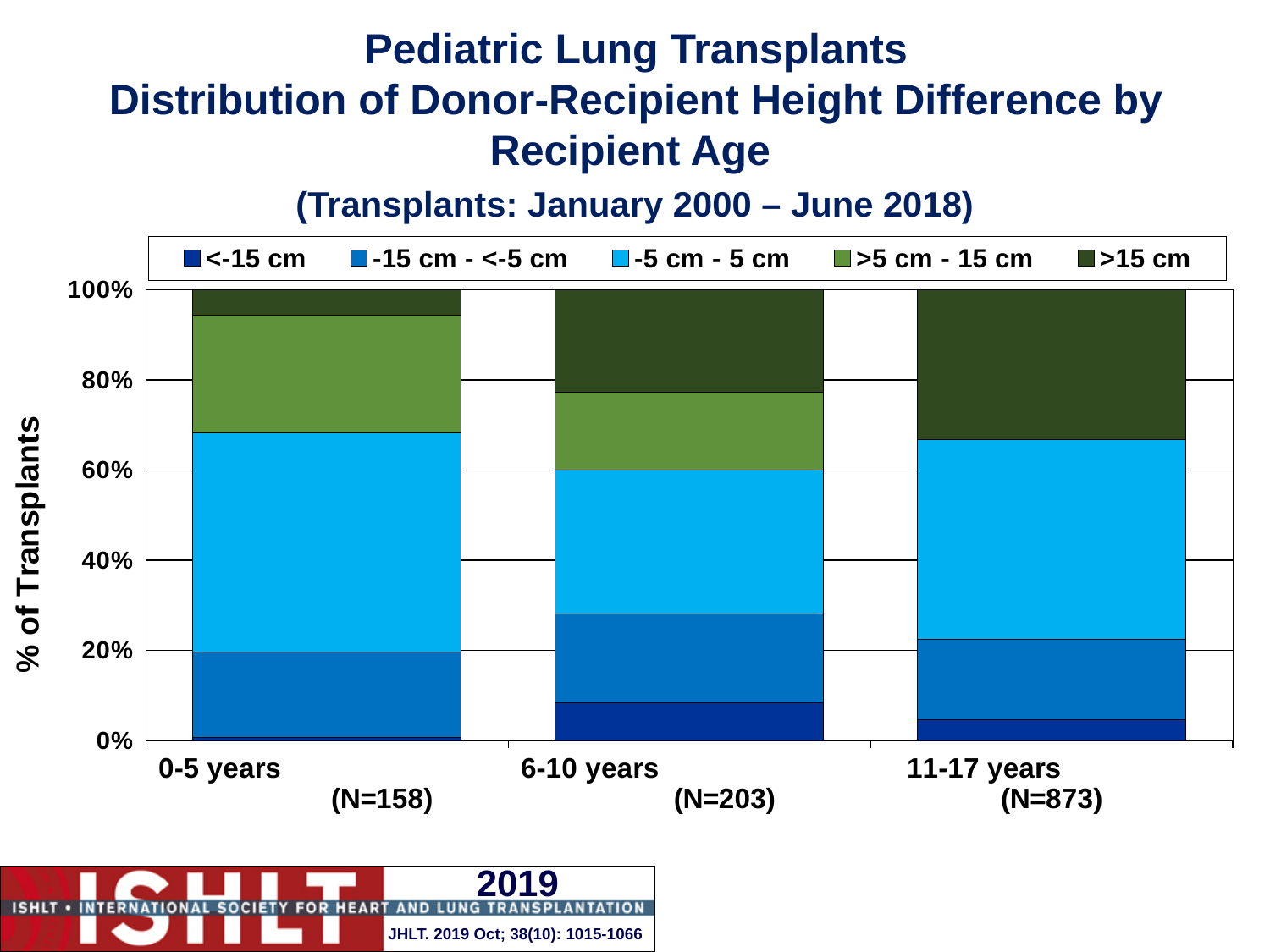
Which age group has the largest share of transplants with a donor-recipient height difference of >15 cm? 11-17 years Which age group has the largest share of transplants in the >5 cm - 15 cm category? 0-5 years What kind of chart is shown on the slide? Stacked bar chart What is the time period of transplants covered by the chart, as stated in the title? January 2000 – June 2018 How many height-difference categories does the legend list? 5 How many recipient age groups are shown on the x axis? 3 Which age group has the largest share of transplants in the <-15 cm category? 6-10 years Which age group has the smallest share of transplants with a donor-recipient height difference of >15 cm? 0-5 years What is the number of transplants (N) for the 11-17 years age group? N=873 Does the share of transplants with a height difference of >15 cm rise or fall from the 0-5 years group to the 11-17 years group? Rise Is the share of >15 cm transplants larger for 11-17 years or for 0-5 years? 11-17 years What is the number of transplants (N) for the 0-5 years age group? N=158